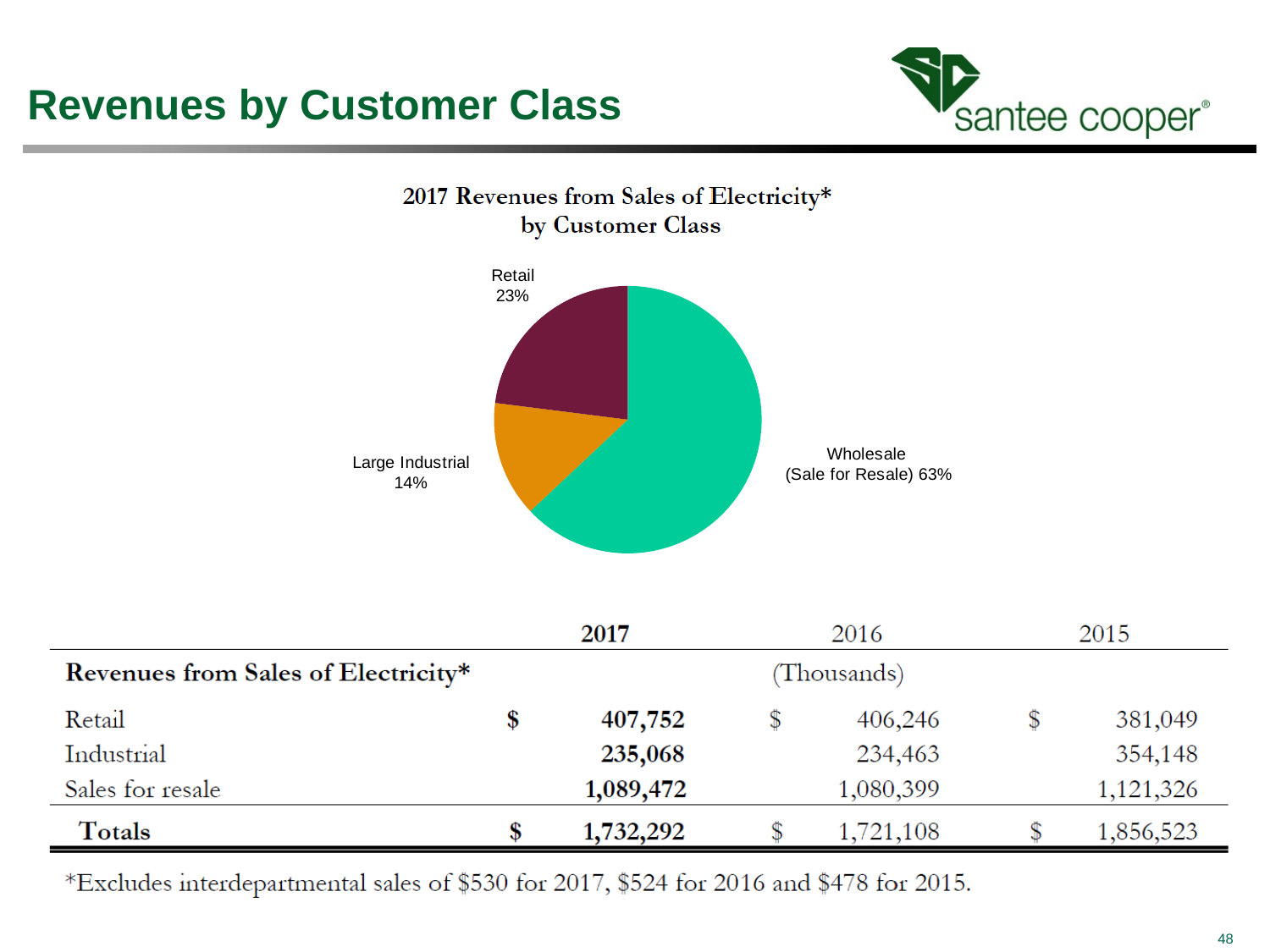
Which customer class has the smallest slice of the pie? Large Industrial Which slice is larger, Retail or Large Industrial? Retail What share of 2017 revenues from sales of electricity comes from Wholesale (Sale for Resale)? 63% What colour is the Wholesale (Sale for Resale) slice? green What kind of chart is shown on the slide? pie chart Which customer class has the largest slice of the pie? Wholesale (Sale for Resale) What is the difference in percentage points between the Retail share and the Large Industrial share? 9 What is the difference in percentage points between the Wholesale (Sale for Resale) share and the Retail share? 40 What is the title of the pie chart? 2017 Revenues from Sales of Electricity* by Customer Class What share of the pie is Large Industrial? 14% How many slices does the pie chart have? 3 What share of the pie is Retail? 23%